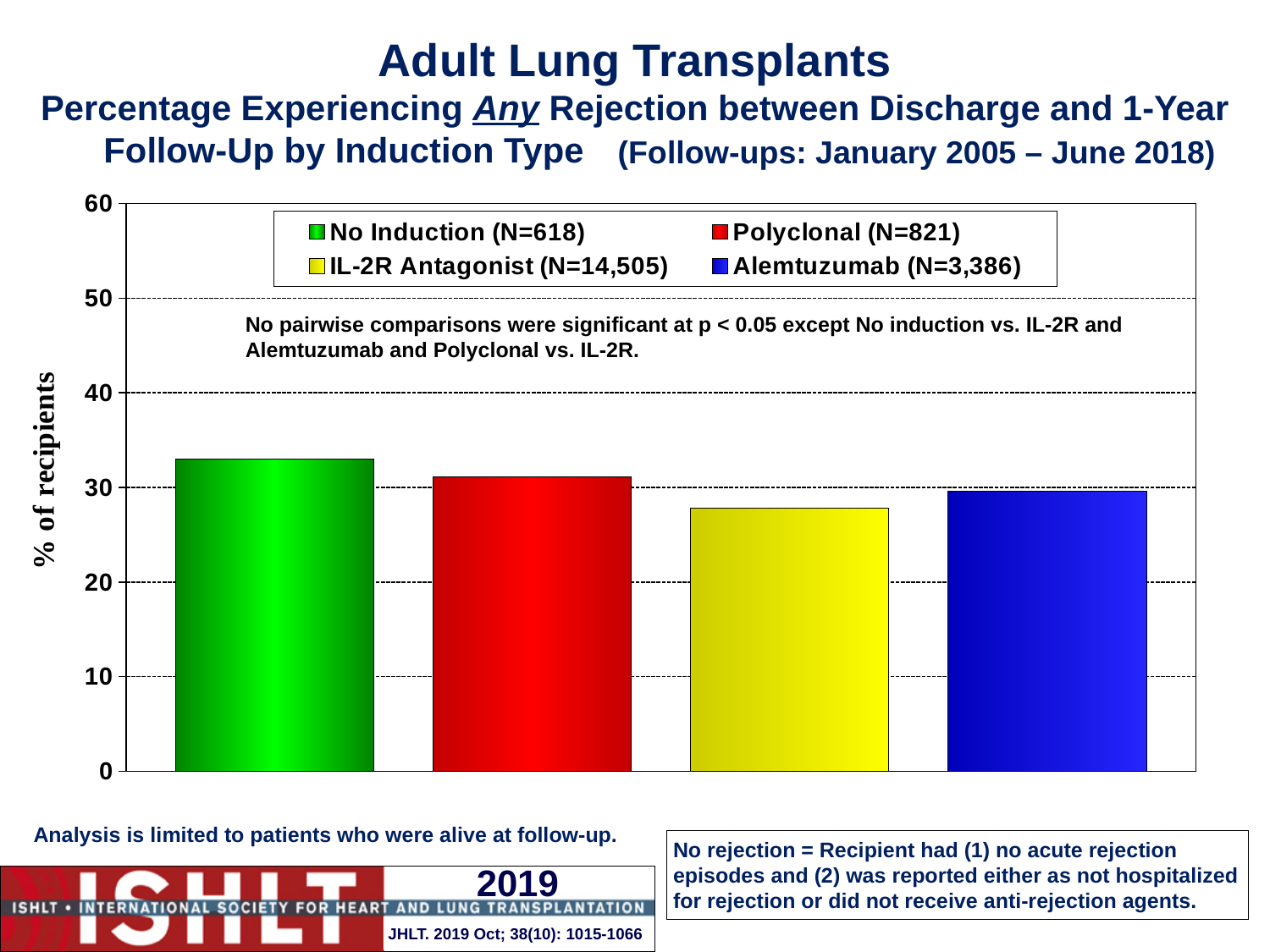
What kind of chart is shown on the slide? bar chart Is the value for No Induction greater or less than 30? greater Which induction type has the lowest percentage of recipients experiencing any rejection? IL-2R Antagonist Which is larger, the value for No Induction or the value for IL-2R Antagonist? No Induction Is the value for IL-2R Antagonist greater or less than 30? less What is the N shown in the legend for IL-2R Antagonist? 14,505 Which induction type has the highest percentage of recipients experiencing any rejection? No Induction What is the label on the y axis? % of recipients How many bars are plotted in the chart? 4 Is the value for Alemtuzumab greater or less than 40? less How many series does the legend list? 4